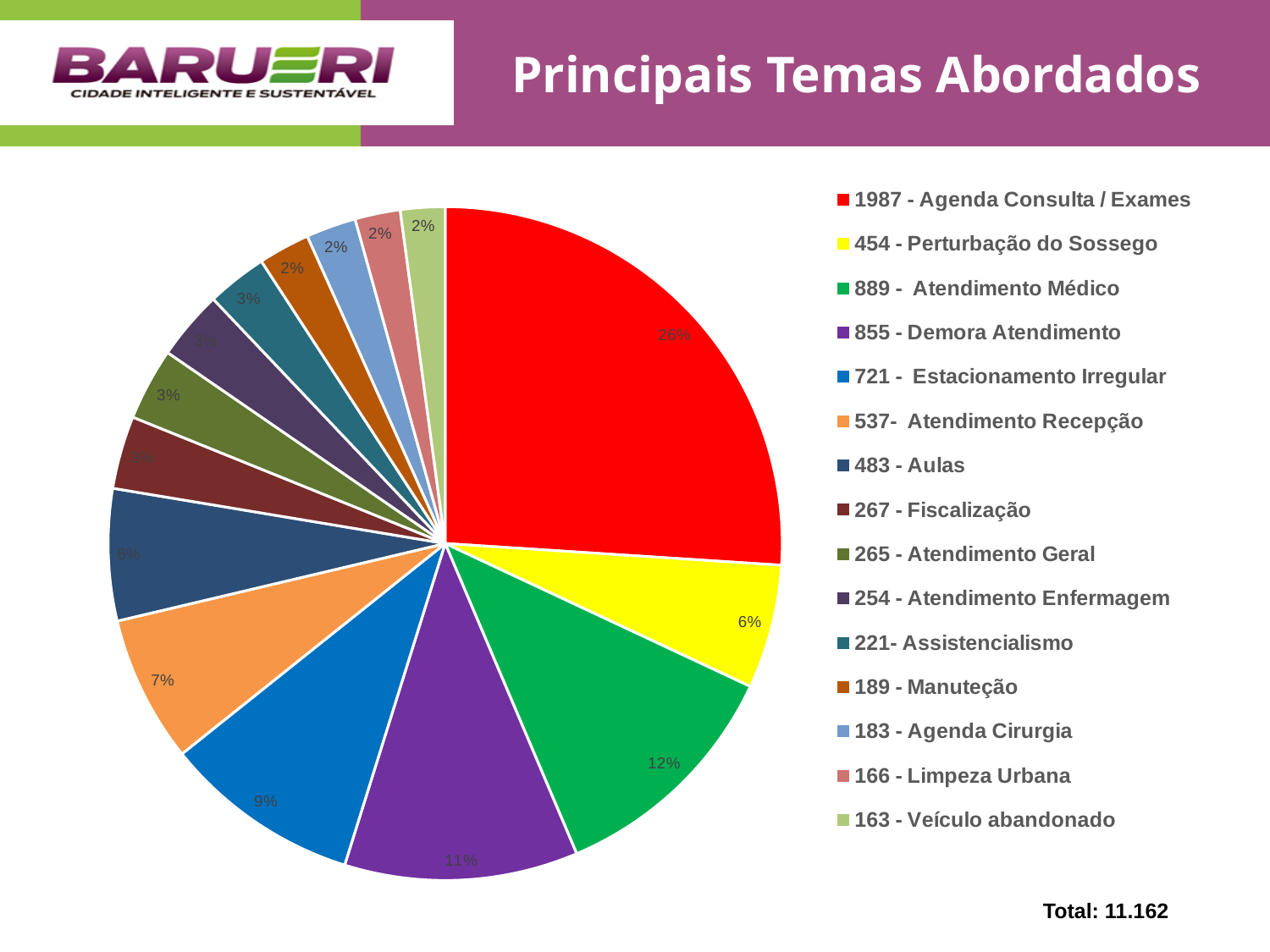
What percentage is shown for 537 - Atendimento Recepção? 7% What percentage is shown for 889 - Atendimento Médico? 12% What total is printed below the legend? 11.162 Which slice is larger, 855 - Demora Atendimento or 721 - Estacionamento Irregular? 855 - Demora Atendimento What is the difference in percentage points between 1987 - Agenda Consulta / Exames and 889 - Atendimento Médico? 14% What kind of chart is shown on the slide? pie chart How many slices does the pie chart have? 15 What share of the pie does 1987 - Agenda Consulta / Exames represent? 26% What percentage is shown for 721 - Estacionamento Irregular? 9% Which category has the largest slice of the pie? 1987 - Agenda Consulta / Exames What is the title of the chart on the slide? Principais Temas Abordados What percentage is shown for 855 - Demora Atendimento? 11%